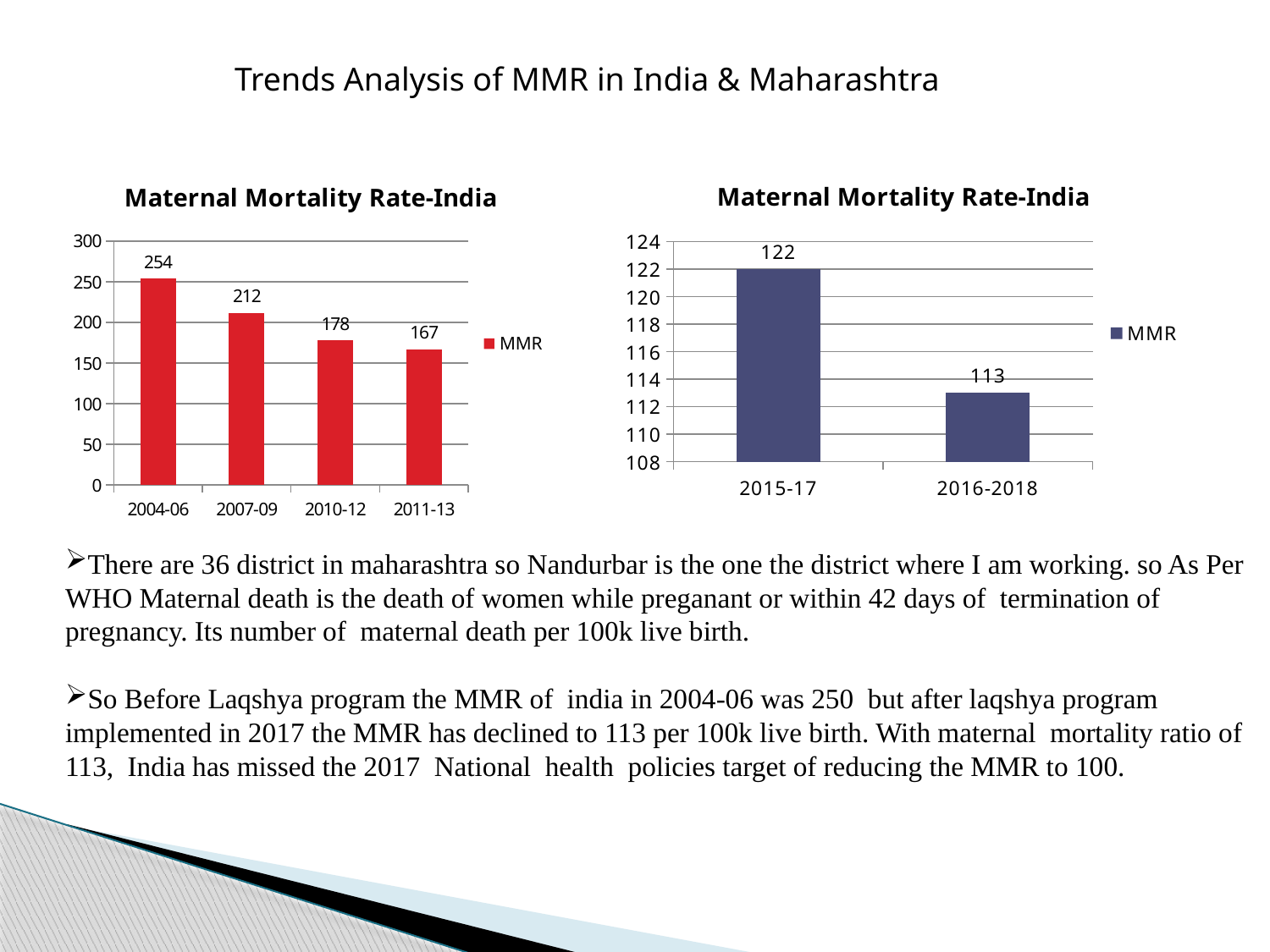
In the left chart, how many periods are shown on the x axis? 4 In the left chart, do the MMR values rise or fall from 2004-06 to 2011-13? fall In the left chart, what is the difference between the MMR for 2004-06 and 2007-09? 42 In the right chart, what is the MMR value for 2015-17? 122 What kind of chart is the right chart? bar chart In the left chart (Maternal Mortality Rate-India, 2004-06 to 2011-13), what is the MMR value for 2004-06? 254 In the left chart, which period has the highest MMR? 2004-06 In the right chart (Maternal Mortality Rate-India, 2015-17 and 2016-2018), what is the MMR value for 2016-2018? 113 In the left chart, which period has the lowest MMR? 2011-13 In the left chart, what is the MMR value for 2010-12? 178 In the right chart, what is the difference between the MMR for 2015-17 and 2016-2018? 9 How many series does the legend of the left chart list? 1